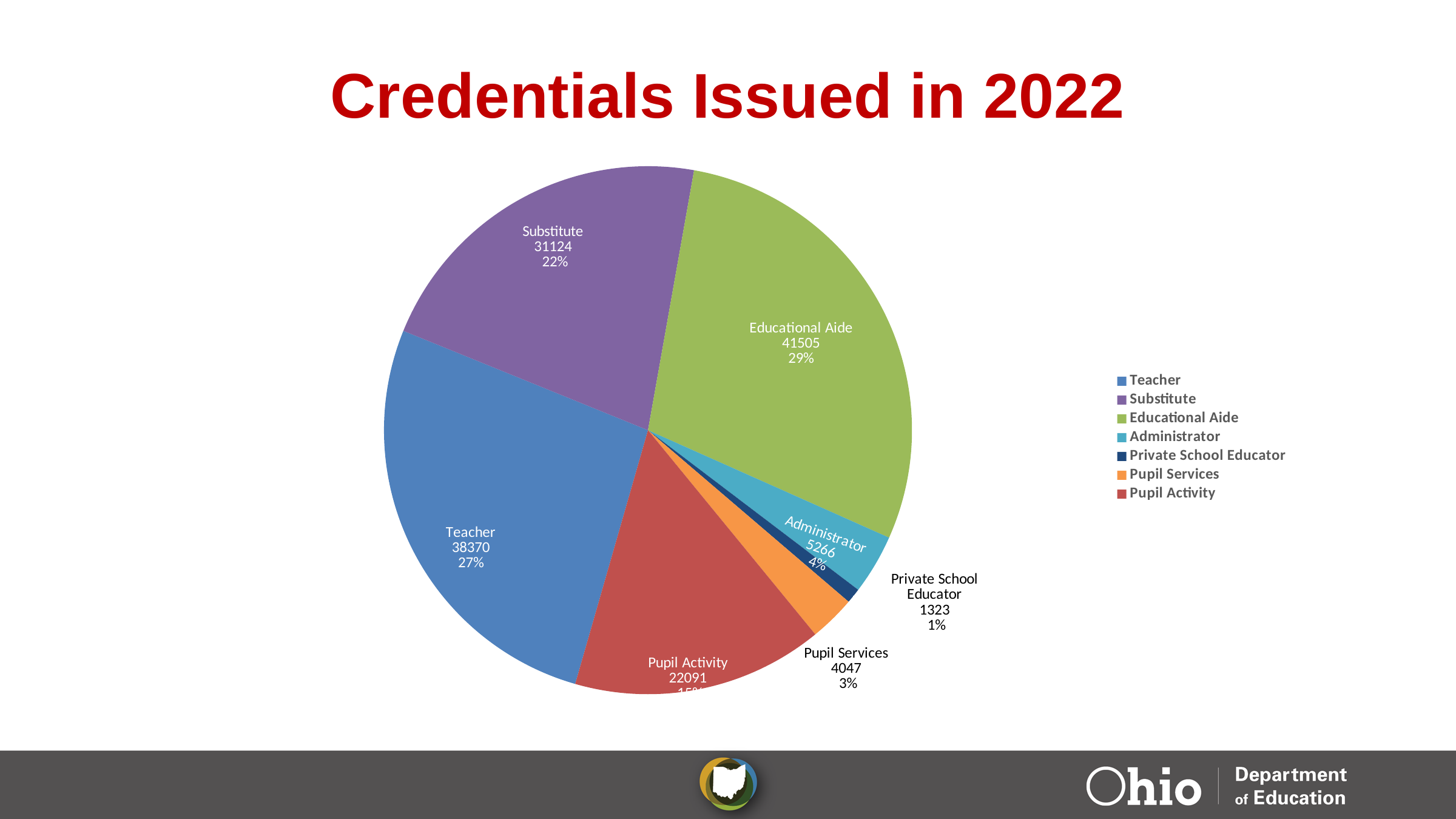
What type of chart is shown on the slide? Pie chart Which is larger, the number of Pupil Services credentials or Administrator credentials? Administrator How many credentials were issued for Educational Aide in 2022? 41505 Which credential category has the largest slice of the pie? Educational Aide What share of the pie does Administrator represent? 4% What is the difference between the number of Educational Aide credentials and Teacher credentials? 3135 How many credentials were issued for Private School Educator? 1323 What is the title of the chart? Credentials Issued in 2022 What share of the pie does Substitute represent? 22% Which credential category has the smallest slice of the pie? Private School Educator How many categories does the legend list? 7 How many credentials were issued for Teacher in 2022? 38370